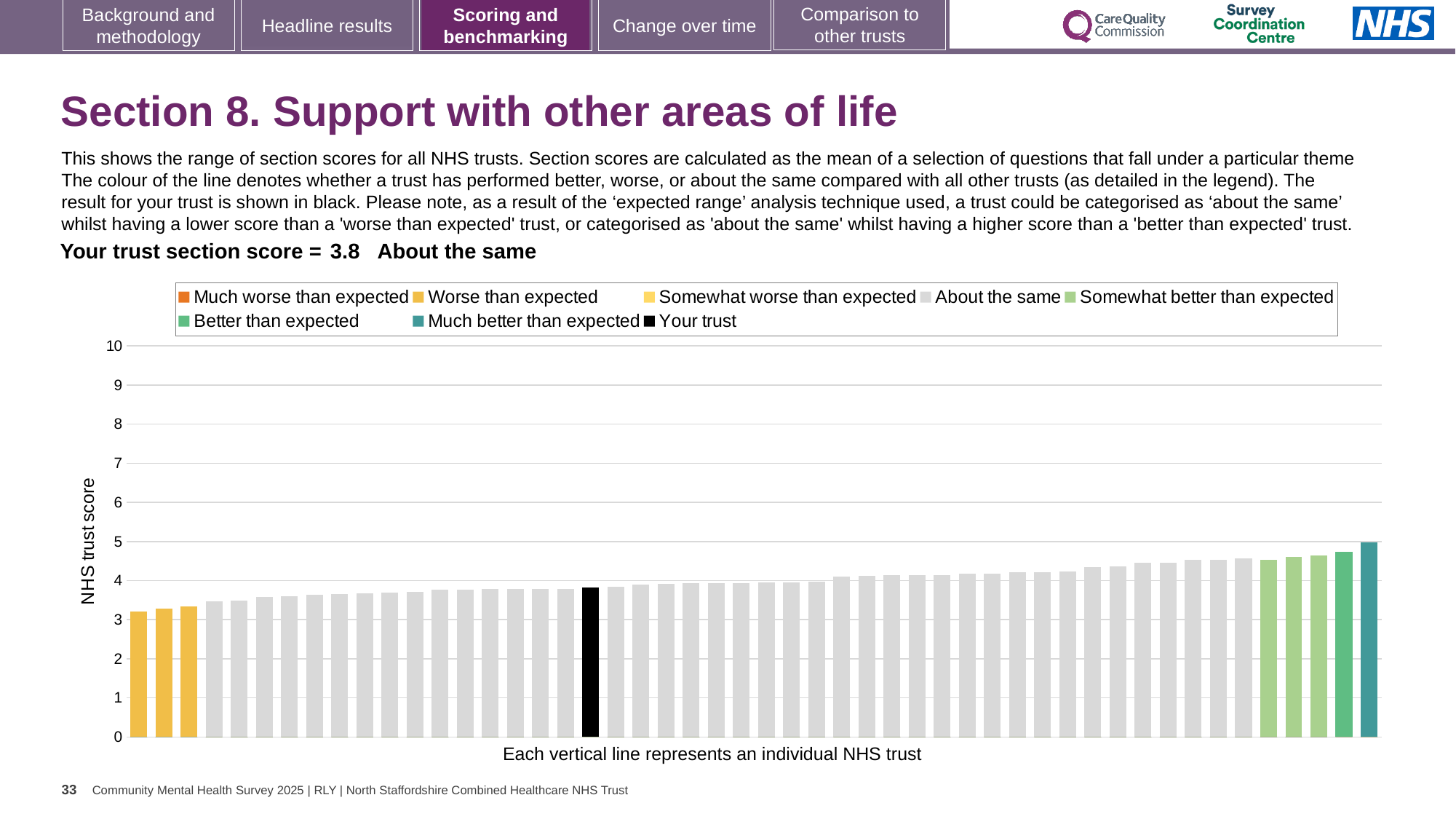
Do the bar values rise or fall from left to right across the chart? rise What is the label on the vertical axis of the chart? NHS trust score How many bars are coloured yellow ('Worse than expected')? 3 What is the section score for your trust shown on the slide? 3.8 What kind of chart is shown on the slide? bar chart Is the value of the black 'Your trust' bar greater or less than 4? less Is the value of the tallest bar (the teal bar on the far right) greater or less than 4? greater What category is your trust's section score placed in, according to the text above the chart? About the same Is the value of the shortest bar (the first yellow bar on the left) greater or less than 3? greater Which is larger: the black 'Your trust' bar or the first yellow bar on the left? the black 'Your trust' bar How many entries does the chart legend list? 8 How many bars are coloured teal ('Much better than expected')? 1